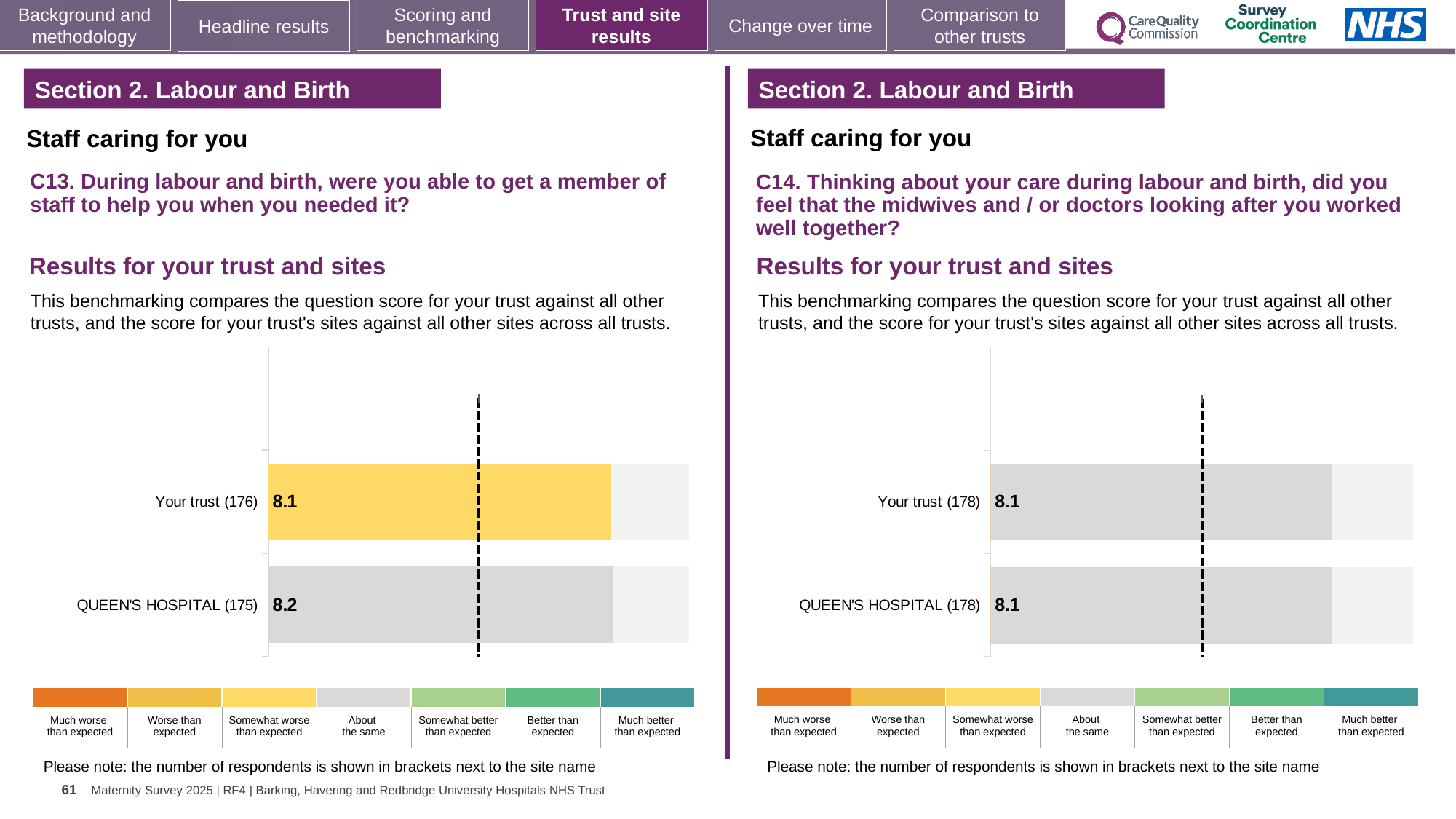
In the C13 chart on the left, what is the score for Your trust (176)? 8.1 In the C13 chart on the left, what is the score for QUEEN'S HOSPITAL (175)? 8.2 How many bars are plotted in the C14 chart on the right? 2 In the C14 chart on the right, what is the difference between the Your trust score and the QUEEN'S HOSPITAL score? 0 What type of chart is used in the C13 chart on the left? Bar chart In the C13 chart on the left, which has the higher score, Your trust or QUEEN'S HOSPITAL? QUEEN'S HOSPITAL How many bars are plotted in the C13 chart on the left? 2 In the C13 chart on the left, what is the difference between the QUEEN'S HOSPITAL score and the Your trust score? 0.1 In the C14 chart on the right, what is the score for Your trust (178)? 8.1 In the C13 chart on the left, which benchmark category does the colour of the Your trust bar correspond to in the legend? Somewhat worse than expected In the C14 chart on the right, what is the score for QUEEN'S HOSPITAL (178)? 8.1 In the C13 chart on the left, how many respondents are shown in brackets for Your trust? 176